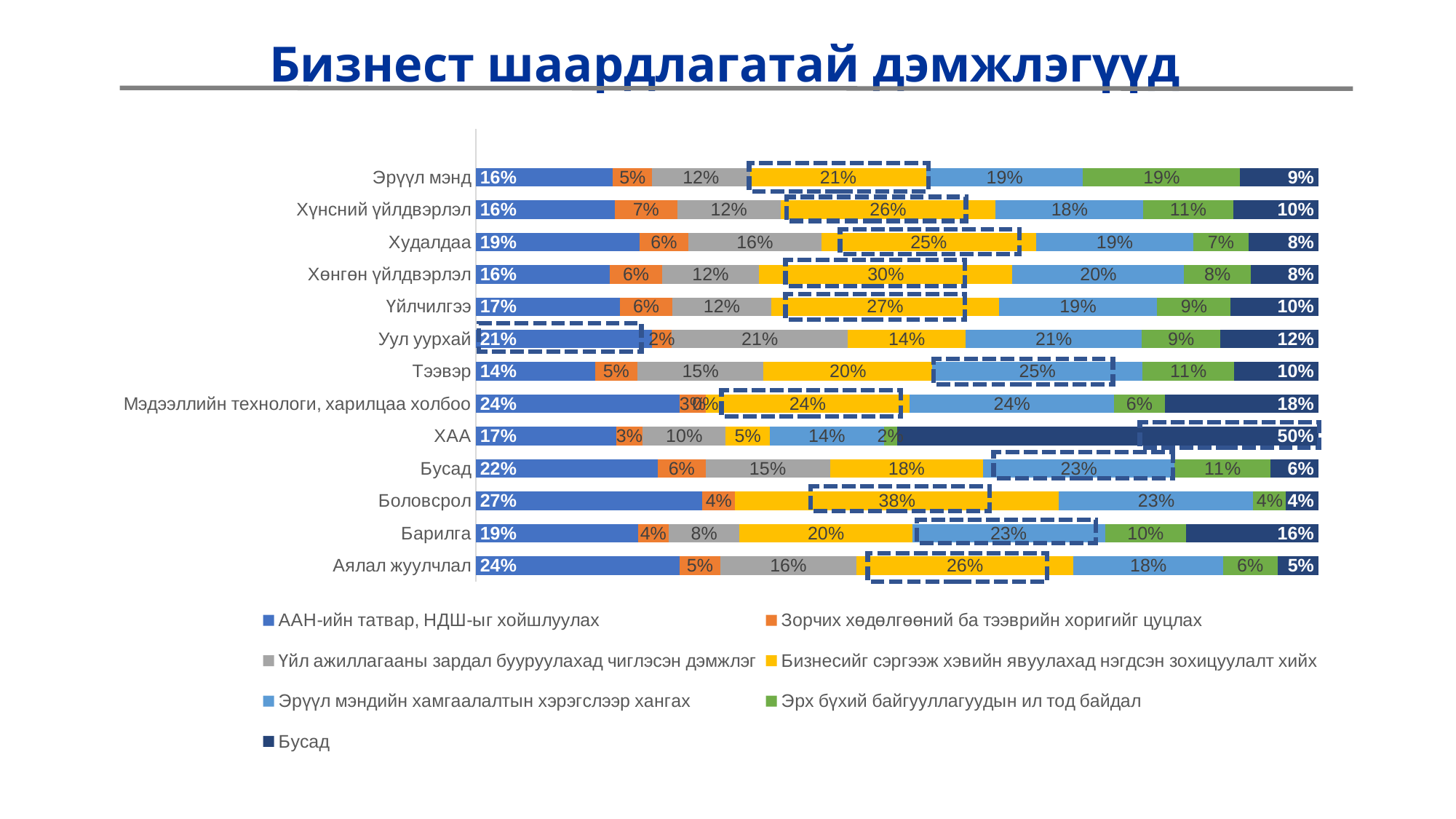
What kind of chart is shown on the slide? Stacked bar chart Which category has the highest value for the yellow 'Бизнесийг сэргээж хэвийн явуулахад нэгдсэн зохицуулалт хийх' series? Боловсрол How many industry categories are listed on the vertical axis? 13 Which is larger: the 'ААН-ийн татвар, НДШ-ыг хойшлуулах' value for Боловсрол or for Тээвэр? Боловсрол How many series does the legend list? 7 What is the difference between the yellow series values for Хөнгөн үйлдвэрлэл (30%) and Эрүүл мэнд (21%)? 9% What is the value of the 'Бизнесийг сэргээж хэвийн явуулахад нэгдсэн зохицуулалт хийх' series (yellow) for Боловсрол? 38% Which category has the highest value for the 'Бусад' series (dark blue)? ХАА What is the value of the 'Эрүүл мэндийн хамгаалалтын хэрэгслээр хангах' series (light blue) for Тээвэр? 25% What is the value of the 'Бусад' series (dark blue) for ХАА? 50% What is the value of the 'Үйл ажиллагааны зардал бууруулахад чиглэсэн дэмжлэг' series (gray) for Уул уурхай? 21% What is the value of the 'ААН-ийн татвар, НДШ-ыг хойшлуулах' series (blue) for Аялал жуулчлал? 24%